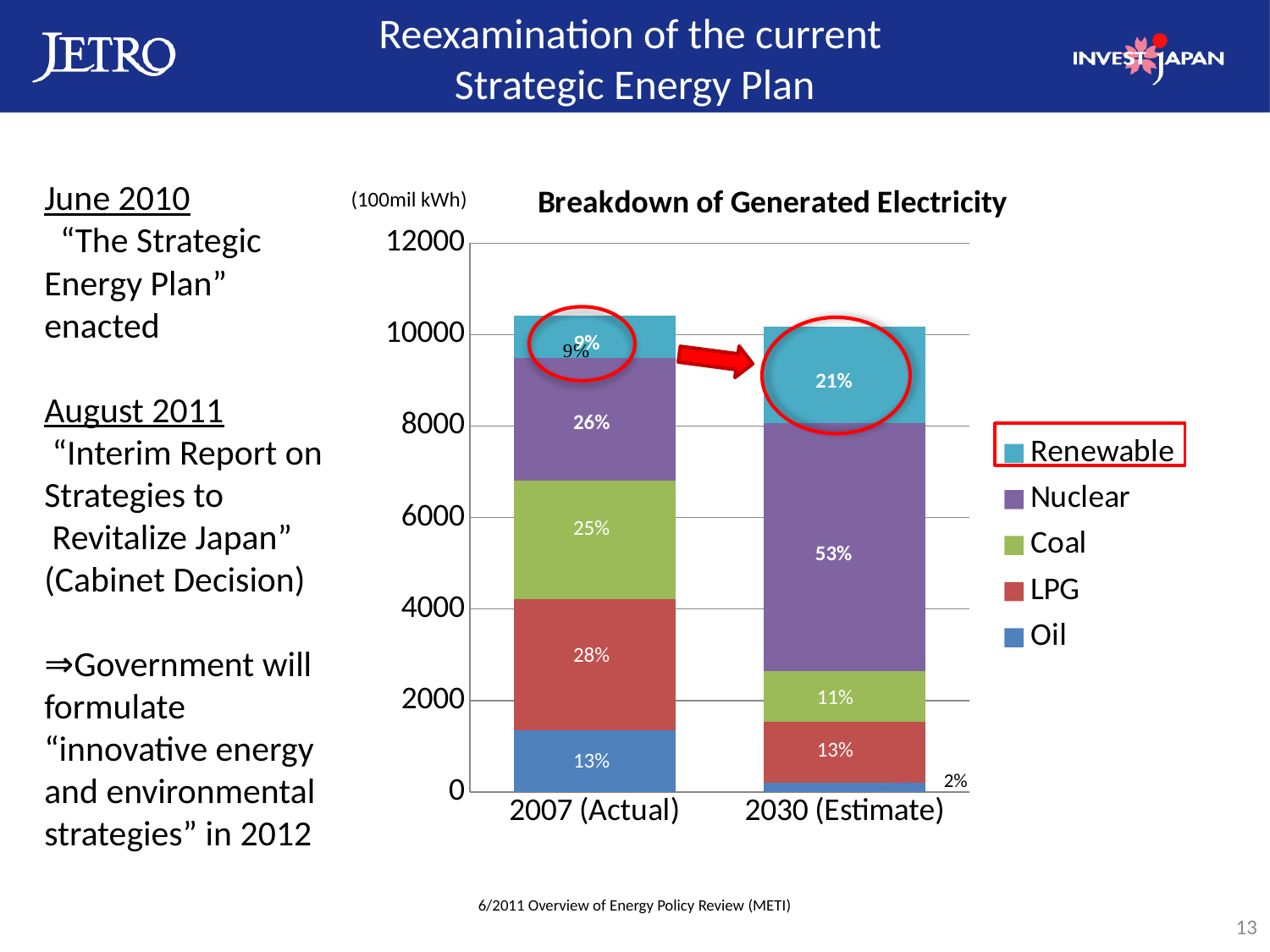
By how many percentage points does the Nuclear share in 2030 (Estimate) exceed the Nuclear share in 2007 (Actual)? 27 What percentage share does Renewable have in the 2030 (Estimate) bar? 21% What percentage share does Oil have in the 2030 (Estimate) bar? 2% Which series has the largest share in the 2030 (Estimate) bar? Nuclear Which series has the smallest share in the 2007 (Actual) bar? Renewable What percentage share does LPG have in the 2007 (Actual) bar? 28% How many series does the legend list? 5 What is the title of the chart? Breakdown of Generated Electricity What percentage share does Nuclear have in the 2007 (Actual) bar? 26% Is the total generated electricity for 2007 (Actual) greater or less than 8000? greater How many categories are shown on the x axis? 2 What type of chart is shown on the slide? stacked bar chart